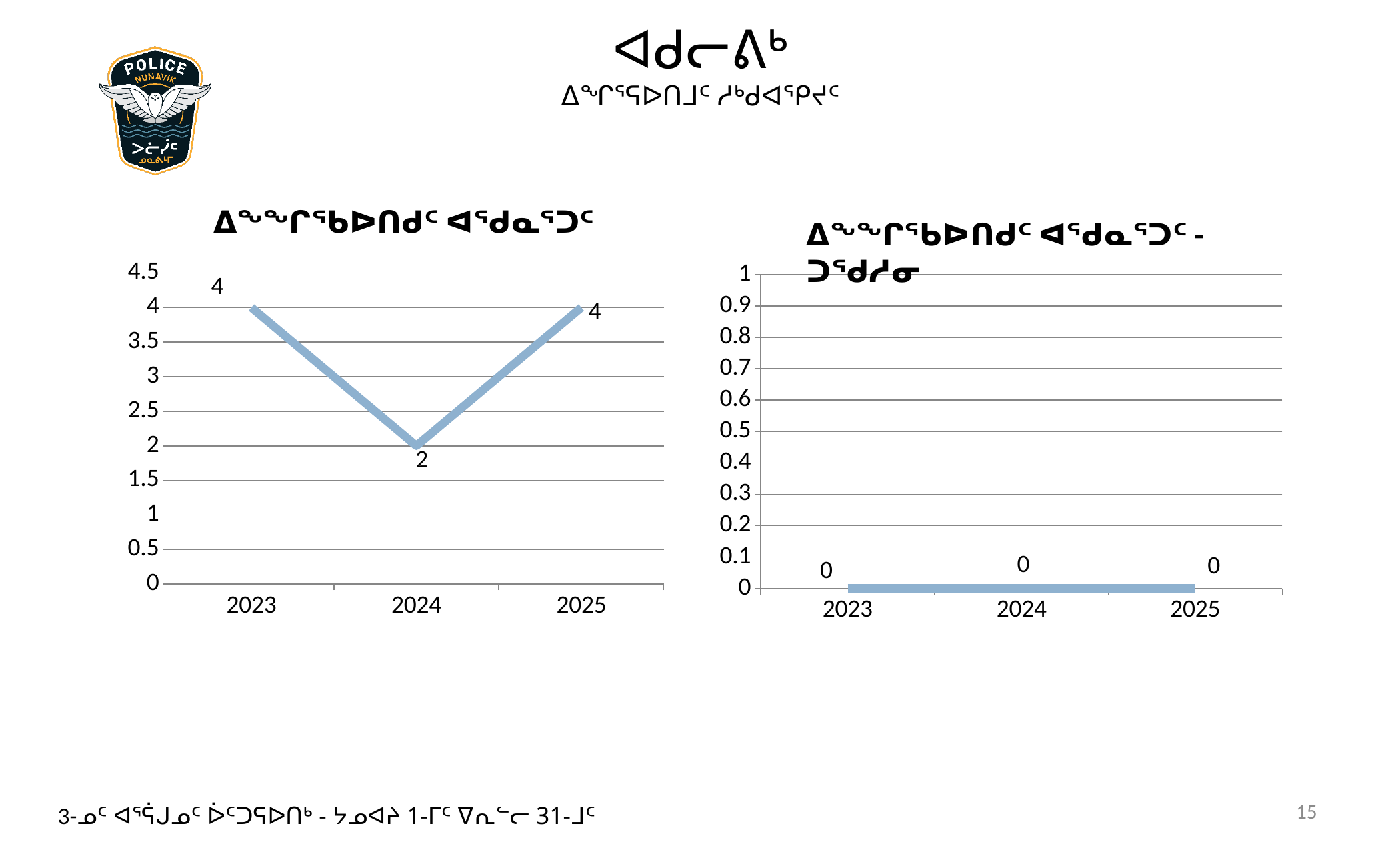
In the left chart, how many years are plotted on the x axis? 3 In the left chart, does the value rise or fall from 2024 to 2025? rise In the left chart, what is the value for 2025? 4 In the left chart, which year has the lowest value? 2024 What kind of chart is the left chart? line chart In the left chart, what is the value for 2023? 4 In the left chart, what is the difference between the values for 2023 and 2024? 2 In the right chart, what is the value for 2024? 0 In the left chart, which is larger, the value for 2024 or the value for 2025? 2025 In the right chart, what is the highest value shown on the y axis? 1 In the left chart, what is the value for 2024? 2 In the left chart, is the value for 2024 greater or less than 3? less